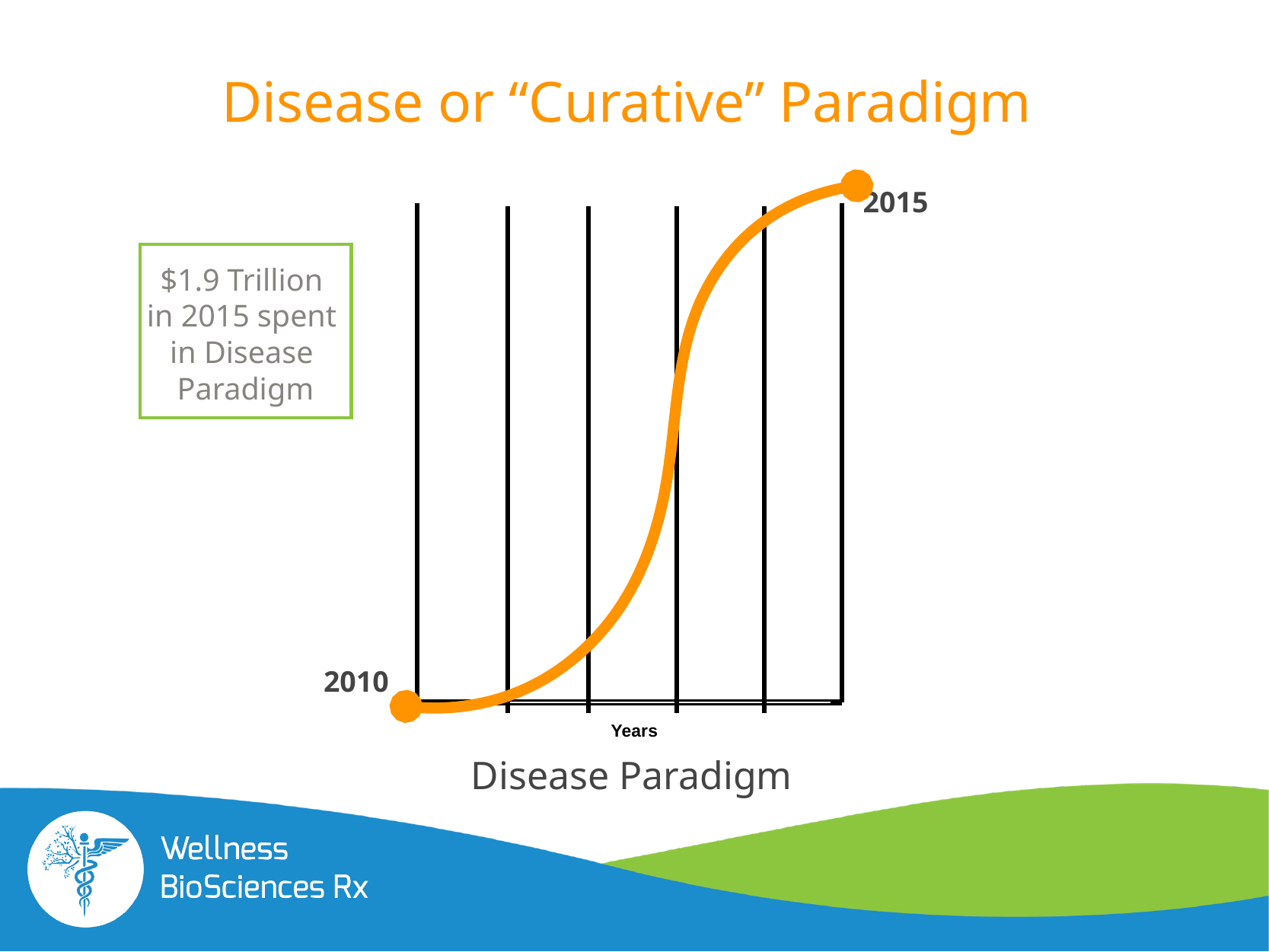
According to the text box next to the chart, how much was spent in the Disease Paradigm in 2015? $1.9 Trillion Which labeled point on the curve is the lowest? 2010 Which labeled point on the curve is the highest? 2015 What is the label on the x axis of the chart? Years Which year is labeled at the starting point of the curve? 2010 What is the title of the slide containing the chart? Disease or "Curative" Paradigm How many labeled data points are marked on the curve? 2 What kind of chart is shown on the slide? line chart Which year is labeled at the ending point of the curve? 2015 Does the plotted curve rise or fall from 2010 to 2015? rises Which labeled point on the curve is higher, 2010 or 2015? 2015